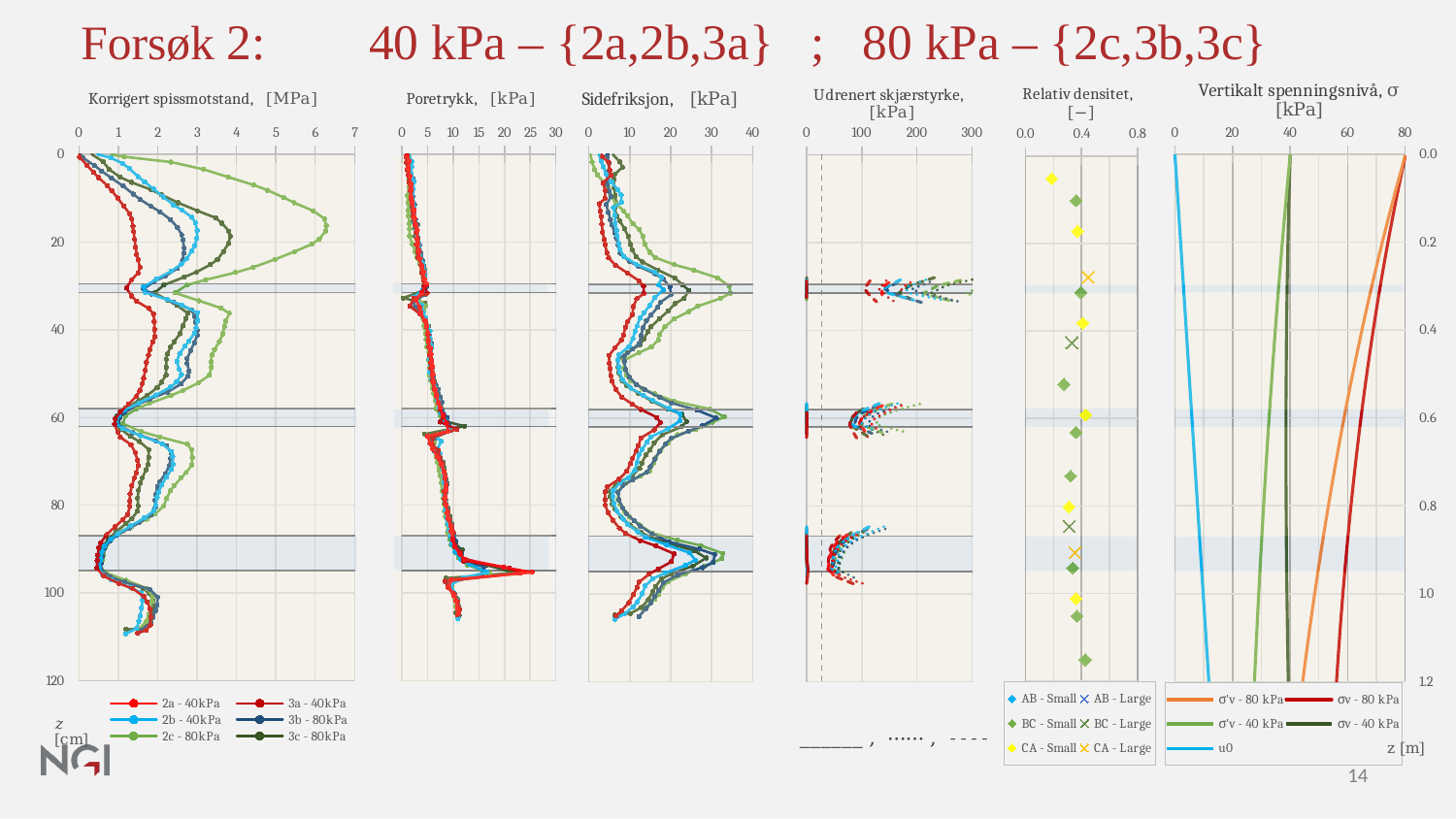
In the 'Relativ densitet' chart, how many series does the legend list? 6 In the 'Vertikalt spenningsnivå' chart, how many series does the legend list? 5 How many charts are shown on the slide? 6 In the 'Korrigert spissmotstand' chart, which series reaches the highest value? 2c - 80kPa In the 'Sidefriksjon' chart, is the peak value of the 2c - 80kPa series near 30 cm depth greater or less than 30 kPa? greater In the 'Korrigert spissmotstand' chart, how many series does the legend list? 6 In the 'Poretrykk' chart, is the peak value near 95 cm depth greater or less than 20 kPa? greater In the 'Vertikalt spenningsnivå' chart, does the u0 series increase or decrease with depth? increase In the 'Vertikalt spenningsnivå' chart, what is the value of the σv - 40 kPa series at depth 0.0 m? 40 In the 'Vertikalt spenningsnivå' chart, what is the value of the σv - 80 kPa series at depth 0.0 m? 80 In the 'Korrigert spissmotstand' chart, is the peak value of the 2c - 80kPa series greater or less than 5 MPa? greater What kind of chart is the 'Korrigert spissmotstand' chart? line chart